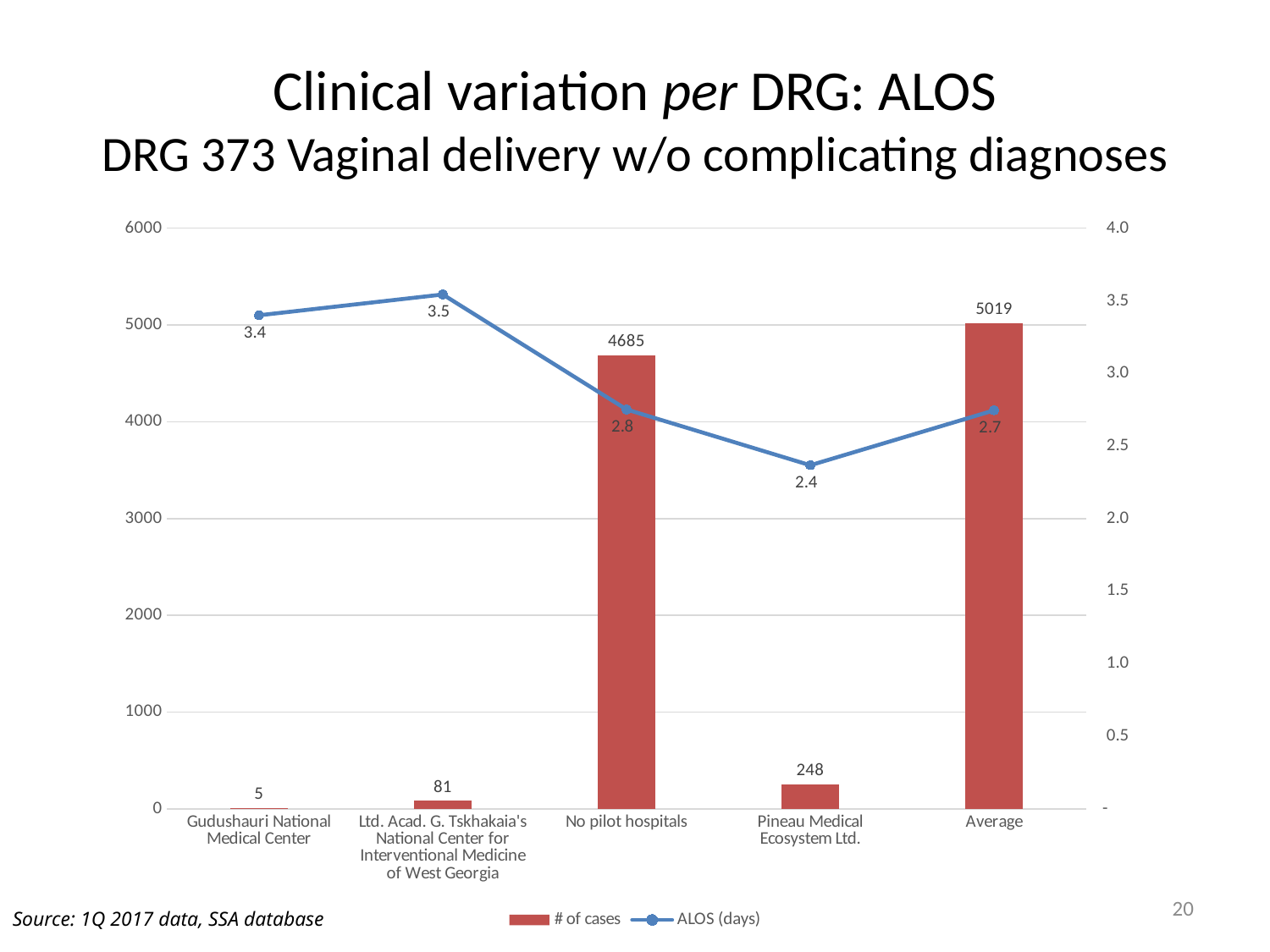
Which category has the lowest number of cases? Gudushauri National Medical Center What is the ALOS (days) value for Pineau Medical Ecosystem Ltd.? 2.4 What kind of chart is this? Combined bar and line chart How many cases are shown for No pilot hospitals? 4685 What is the number of cases for Gudushauri National Medical Center? 5 What is the source of the data stated on the slide? 1Q 2017 data, SSA database What is the ALOS (days) value for Average? 2.7 Which has more cases, Pineau Medical Ecosystem Ltd. or Ltd. Acad. G. Tskhakaia's National Center for Interventional Medicine of West Georgia? Pineau Medical Ecosystem Ltd. How many categories are shown on the x axis? 5 Which category has the highest ALOS (days)? Ltd. Acad. G. Tskhakaia's National Center for Interventional Medicine of West Georgia How many series does the legend list? 2 What is the difference in number of cases between Average and No pilot hospitals? 334